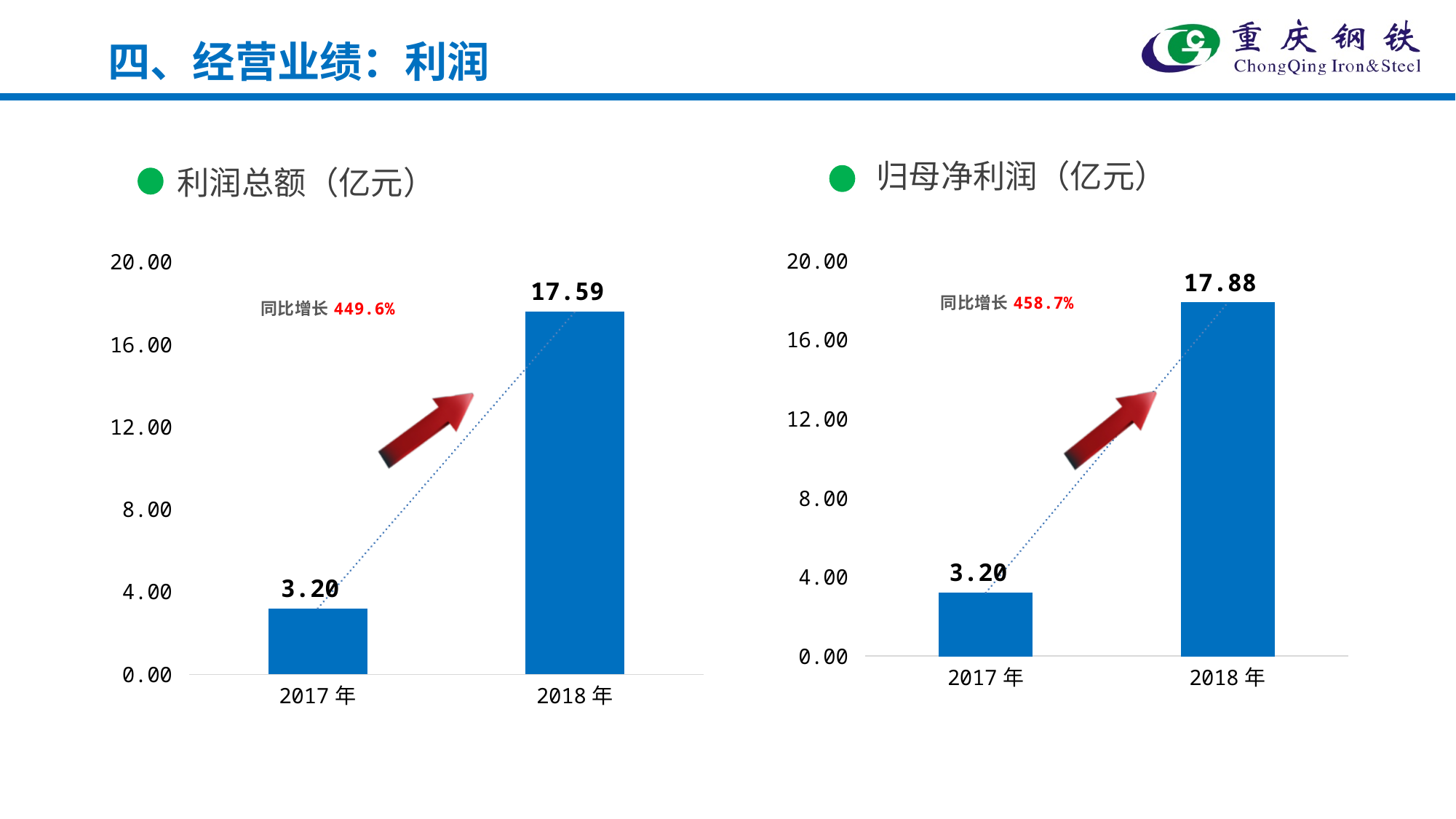
In the 归母净利润（亿元） chart, what is the value for 2018 年? 17.88 In the 利润总额（亿元） chart, what is the value for 2018 年? 17.59 What kind of chart is the 归母净利润（亿元） chart? bar chart In the 归母净利润（亿元） chart, what is the value for 2017 年? 3.20 In the 归母净利润（亿元） chart, do the values rise or fall from 2017 年 to 2018 年? rise In the 归母净利润（亿元） chart, which year has the lowest value? 2017 年 In the 利润总额（亿元） chart, what year-on-year growth rate (同比增长) is annotated? 449.6% In the 利润总额（亿元） chart, how many categories are shown on the x axis? 2 In the 利润总额（亿元） chart, what is the value for 2017 年? 3.20 In the 归母净利润（亿元） chart, what is the difference between the 2018 年 and 2017 年 values? 14.68 In the 利润总额（亿元） chart, which year has the higher value? 2018 年 In the 利润总额（亿元） chart, what is the difference between the 2018 年 and 2017 年 values? 14.39